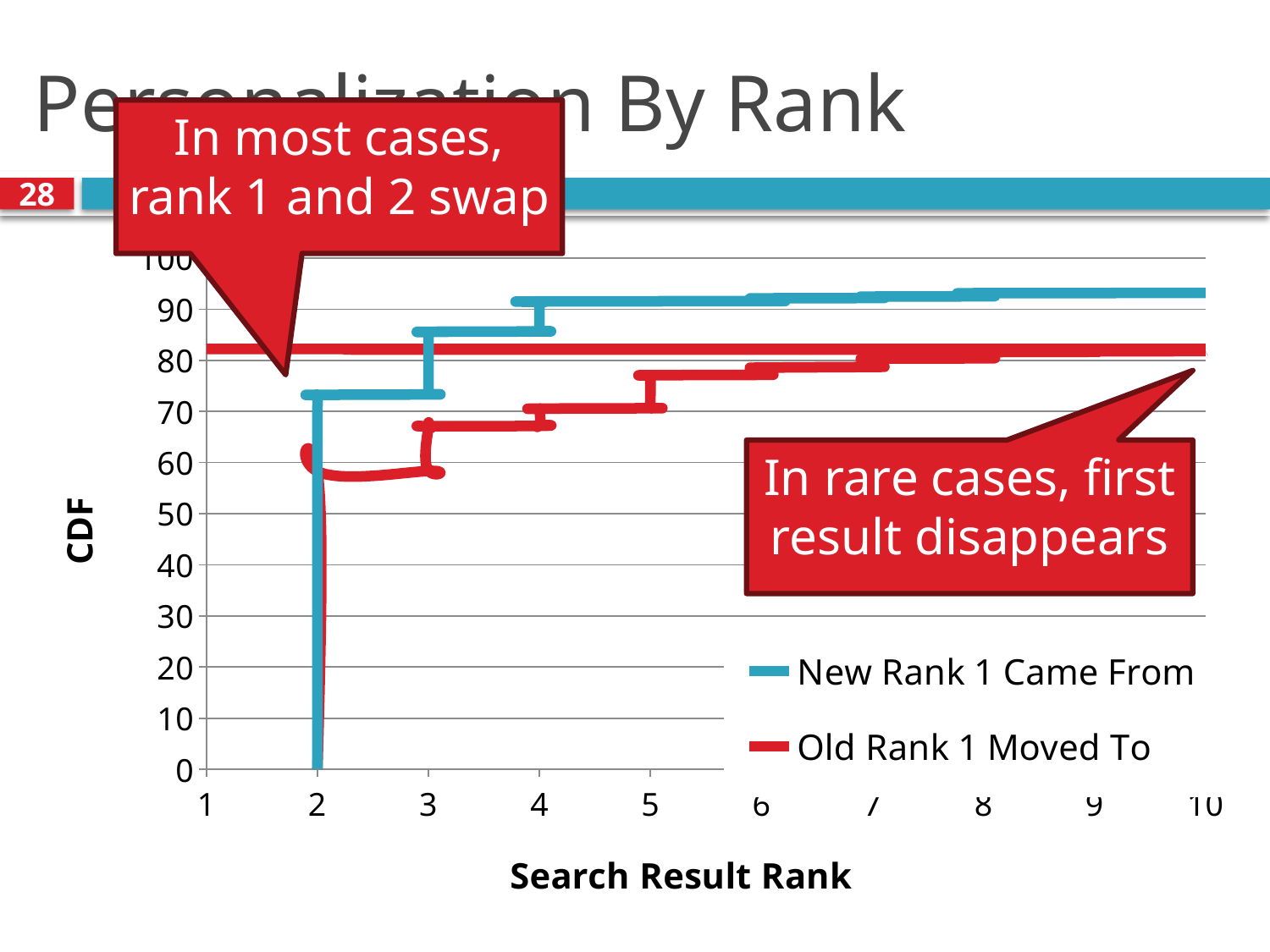
At rank 10, which series has the higher CDF value, New Rank 1 Came From or Old Rank 1 Moved To? New Rank 1 Came From What are the two series named in the legend? New Rank 1 Came From; Old Rank 1 Moved To Do the CDF values rise or fall as Search Result Rank increases from 2 to 10? rise What kind of chart is shown on the slide? line chart Is the value of the New Rank 1 Came From series at rank 5 greater or less than 80? greater Is the value of the Old Rank 1 Moved To series at rank 4 greater or less than 80? less Is the value of the Old Rank 1 Moved To series at rank 10 greater or less than 90? less How many rank values are labelled on the x axis? 10 How many series does the chart legend list? 2 What is the label of the x axis? Search Result Rank